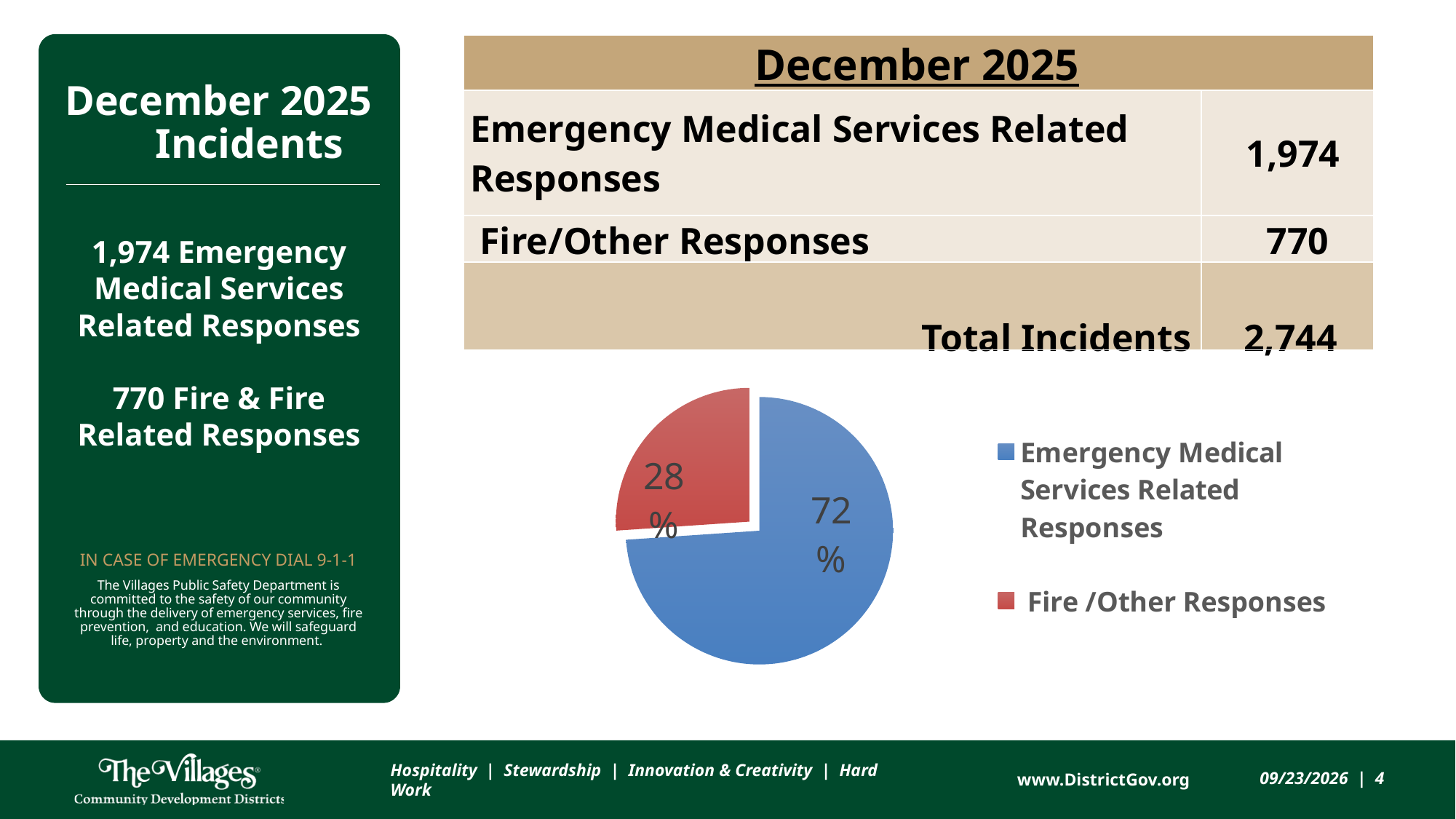
Which slice of the pie chart is the largest? Emergency Medical Services Related Responses What colour is the Fire /Other Responses slice in the pie chart? red Is the share for Fire /Other Responses greater or less than 50%? less How many slices does the pie chart have? 2 What share of the pie does Emergency Medical Services Related Responses represent? 72% How many entries does the pie chart's legend list? 2 What colour is the Emergency Medical Services Related Responses slice in the pie chart? blue What is the difference in percentage points between the Emergency Medical Services Related Responses slice and the Fire /Other Responses slice? 44 What share of the pie does Fire /Other Responses represent? 28% Which is larger in the pie chart: Emergency Medical Services Related Responses or Fire /Other Responses? Emergency Medical Services Related Responses What kind of chart is shown on the slide? pie chart Which slice of the pie chart is the smallest? Fire /Other Responses